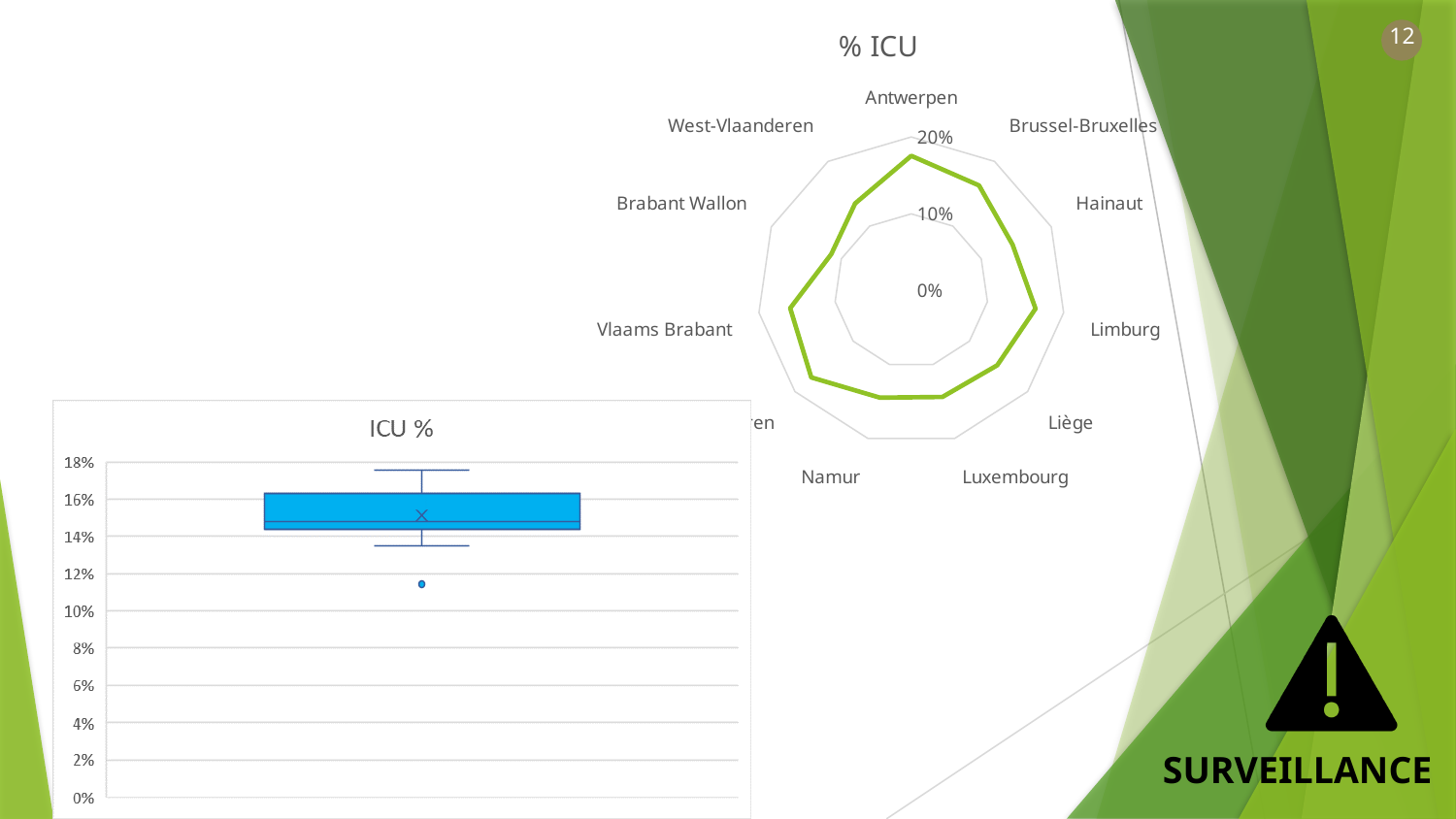
In the '% ICU' radar chart, is the value for Antwerpen greater or less than 10%? greater What kind of chart is the '% ICU' chart on the right? radar chart In the '% ICU' radar chart, which category has the highest value? Antwerpen In the '% ICU' radar chart, is the value for Limburg greater or less than 10%? greater How many category axes does the '% ICU' radar chart have? 11 In the '% ICU' radar chart, is the value for Hainaut greater or less than 20%? less In the '% ICU' radar chart, what is the highest value shown on the radial axis? 20% What kind of chart is the 'ICU %' chart on the left? box plot What is the title of the radar chart? % ICU